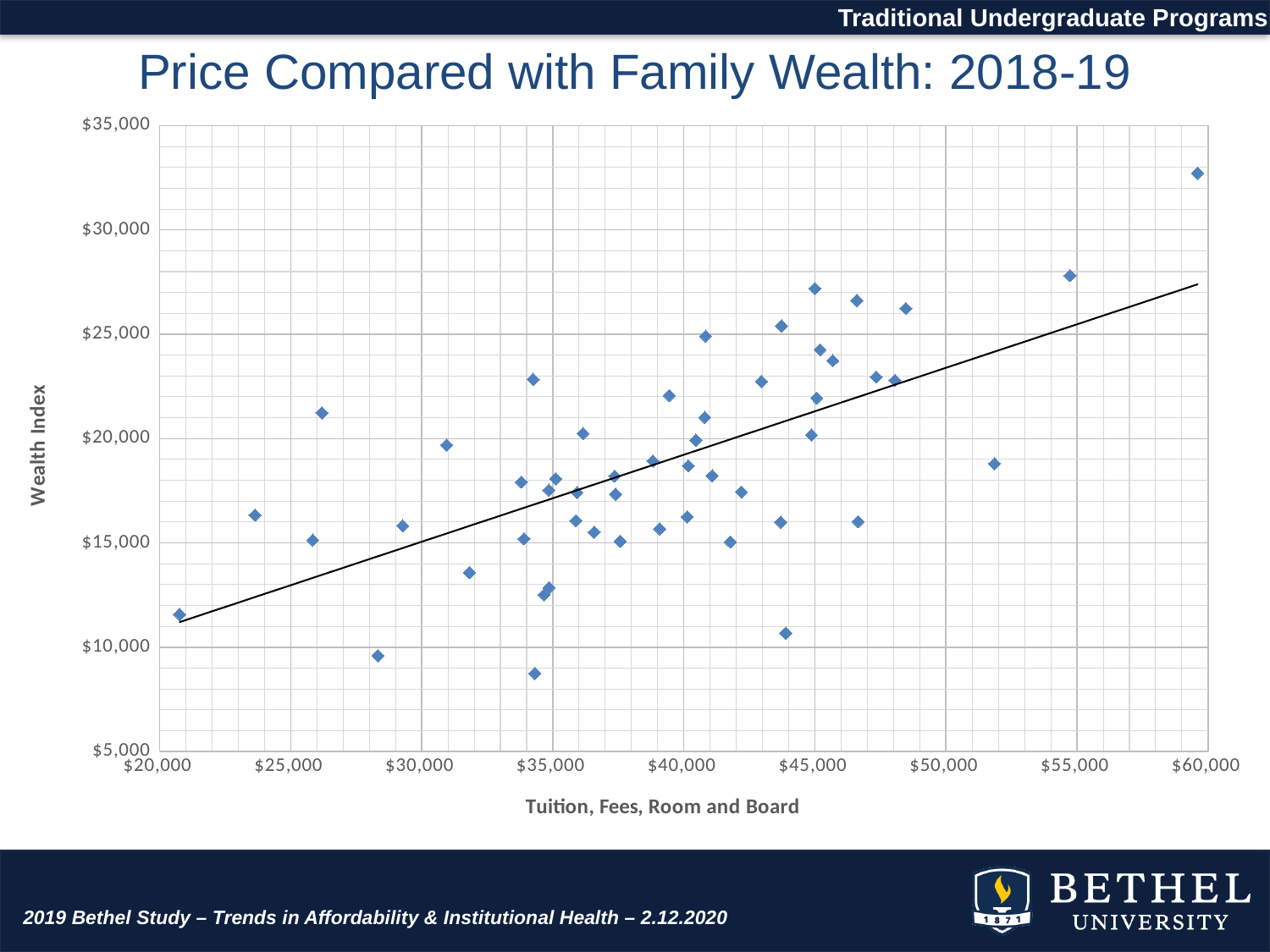
What kind of chart is shown on the slide? Scatter chart Is the Wealth Index of the point with the highest Tuition, Fees, Room and Board (near $60,000) greater or less than $30,000? greater Which has the higher Wealth Index: the point at about $55,000 tuition or the point at about $52,000 tuition? The point at about $55,000 tuition Is the value of the trend line at $60,000 Tuition, Fees, Room and Board greater or less than $30,000? less Is the Wealth Index of the point with the lowest Tuition, Fees, Room and Board (near $20,000) greater or less than $15,000? less Does the fitted trend line rise or fall as Tuition, Fees, Room and Board increases? Rises What is the label of the horizontal axis? Tuition, Fees, Room and Board What is the title of the chart? Price Compared with Family Wealth: 2018-19